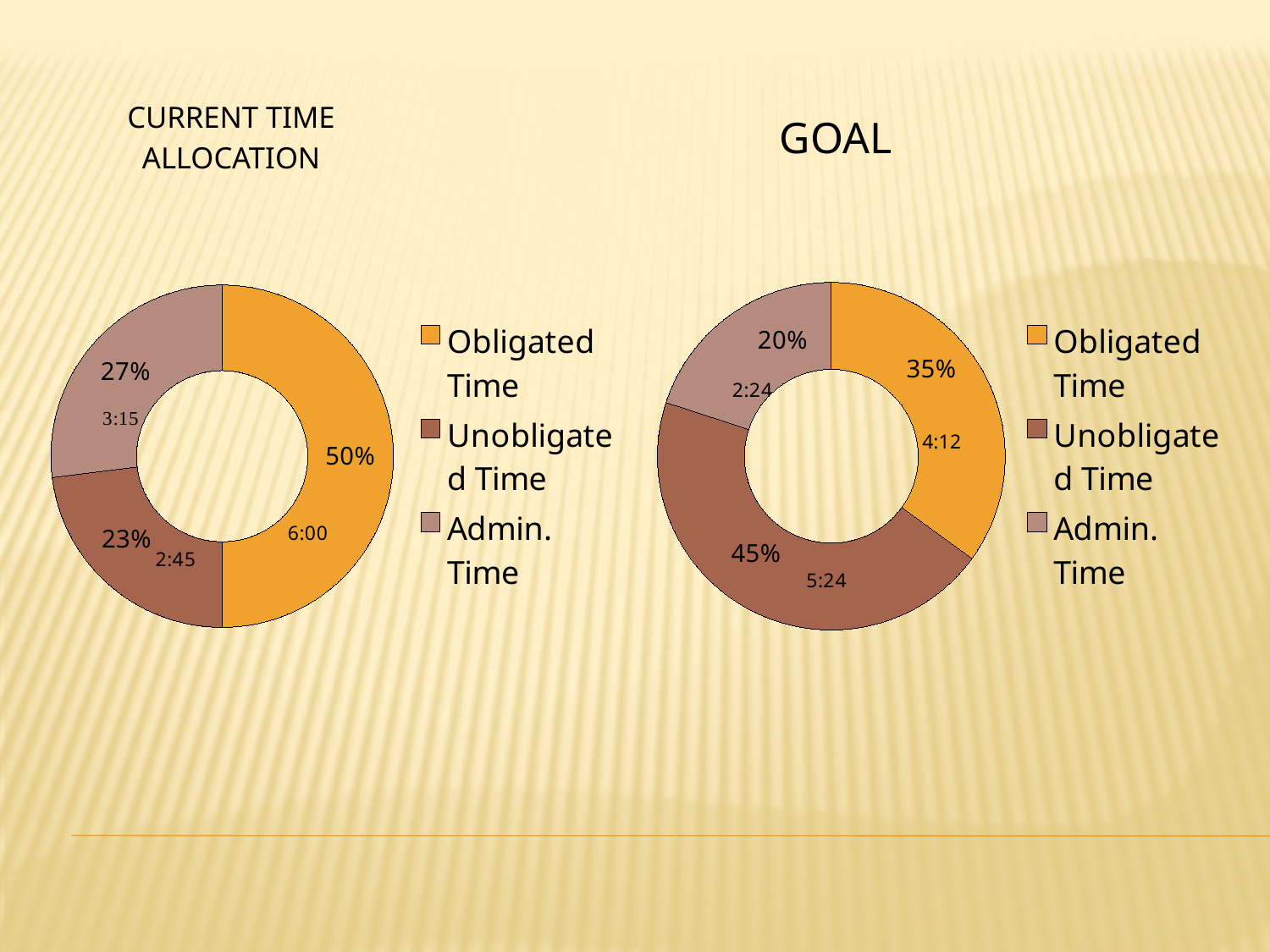
How many categories does the GOAL chart show? 3 In the GOAL chart, which is larger, Unobligated Time or Obligated Time? Unobligated Time In the CURRENT TIME ALLOCATION chart, what percentage is Obligated Time? 50% In the CURRENT TIME ALLOCATION chart, which category has the largest share? Obligated Time In the CURRENT TIME ALLOCATION chart, what is the difference in percentage points between Obligated Time and Unobligated Time? 27 What kind of chart is the CURRENT TIME ALLOCATION chart? Doughnut chart In the GOAL chart, which category has the smallest share? Admin. Time In the CURRENT TIME ALLOCATION chart, what colour represents Unobligated Time? Brown In the GOAL chart, what time value is shown for Obligated Time? 4:12 In the GOAL chart, what percentage is Unobligated Time? 45% In the GOAL chart, what share of the whole does Admin. Time represent? 20% In the CURRENT TIME ALLOCATION chart, what time value is shown for Admin. Time? 3:15